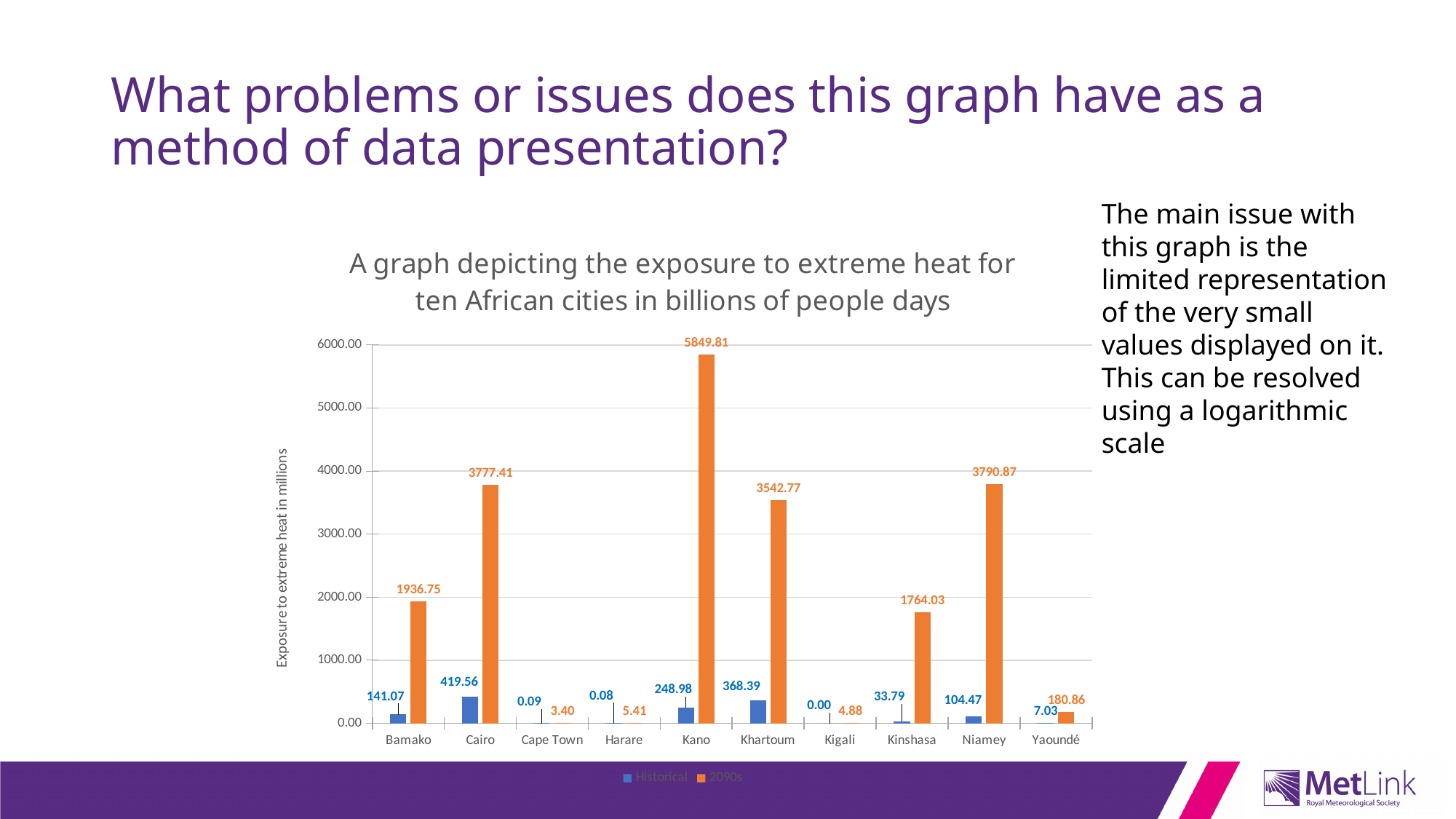
What is the difference between the 2090s and Historical values for Kano? 5600.83 How many cities are shown on the x axis? 10 Which city has the lowest Historical value? Kigali How many series does the legend list? 2 Which is larger, the 2090s value for Bamako or the 2090s value for Kinshasa? Bamako What is the 2090s value for Yaoundé? 180.86 Is the 2090s value for Khartoum greater or less than 3000.00? greater What is the label of the vertical axis? Exposure to extreme heat in millions What is the Historical value for Cairo? 419.56 What is the 2090s value for Kano? 5849.81 What kind of chart is shown on the slide? Bar chart Which city has the highest 2090s value? Kano